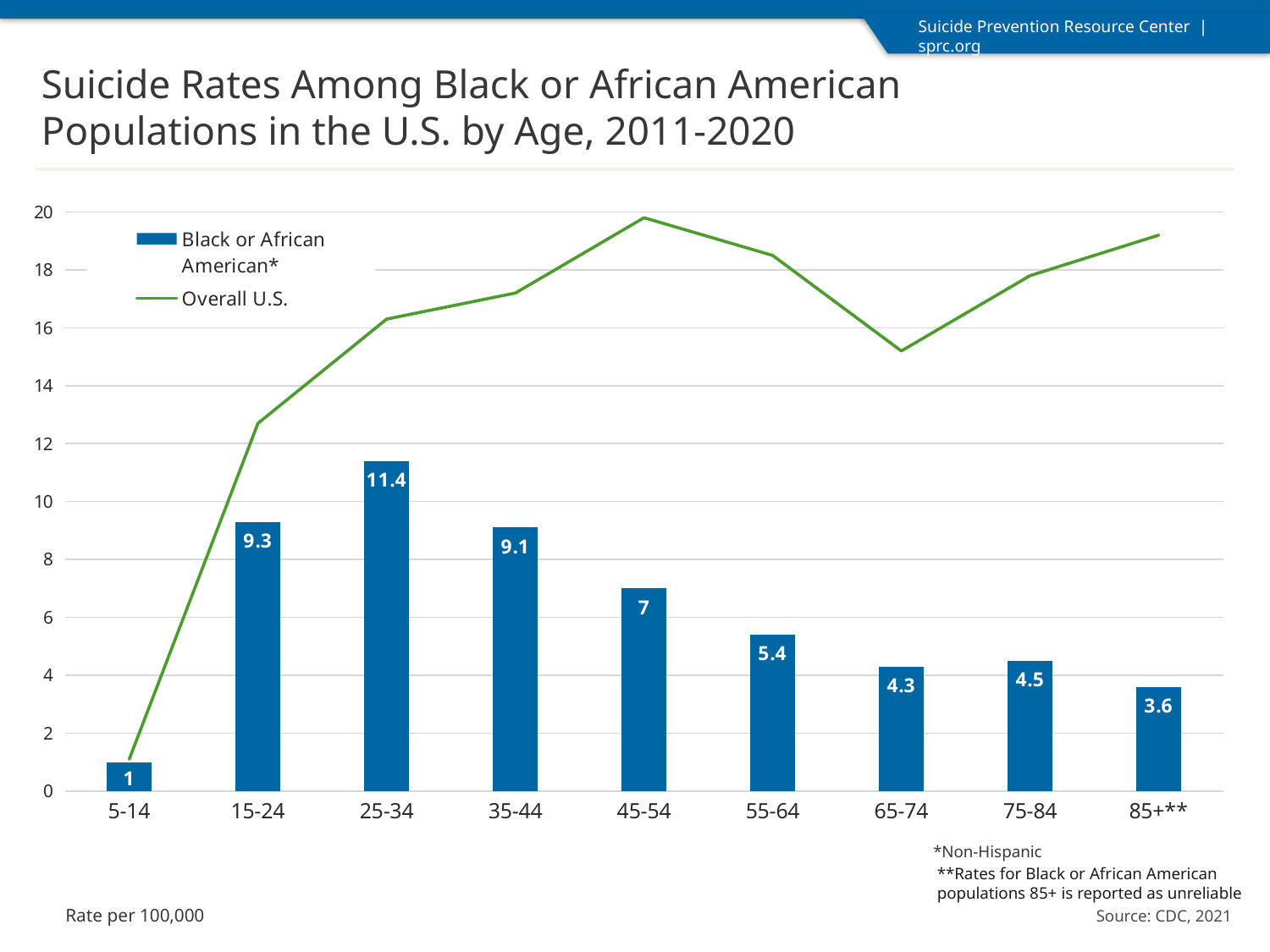
Is the Overall U.S. value for the 65-74 age group greater or less than 16? less Which has the higher Black or African American suicide rate, the 75-84 or the 65-74 age group? 75-84 What kind of chart is shown on the slide? A bar chart combined with a line chart What is the suicide rate for the Black or African American population aged 65-74? 4.3 How many series does the legend list? 2 Which age group has the highest suicide rate among the Black or African American bars? 25-34 What is the difference between the Black or African American rates for the 15-24 and 35-44 age groups? 0.2 How many age groups are shown on the x axis? 9 Is the Overall U.S. value for the 45-54 age group greater or less than 18? greater Which age group has the lowest suicide rate among the Black or African American bars? 5-14 What is the suicide rate for the Black or African American population aged 25-34? 11.4 Do the Black or African American bars rise or fall from the 25-34 age group to the 85+ age group? fall